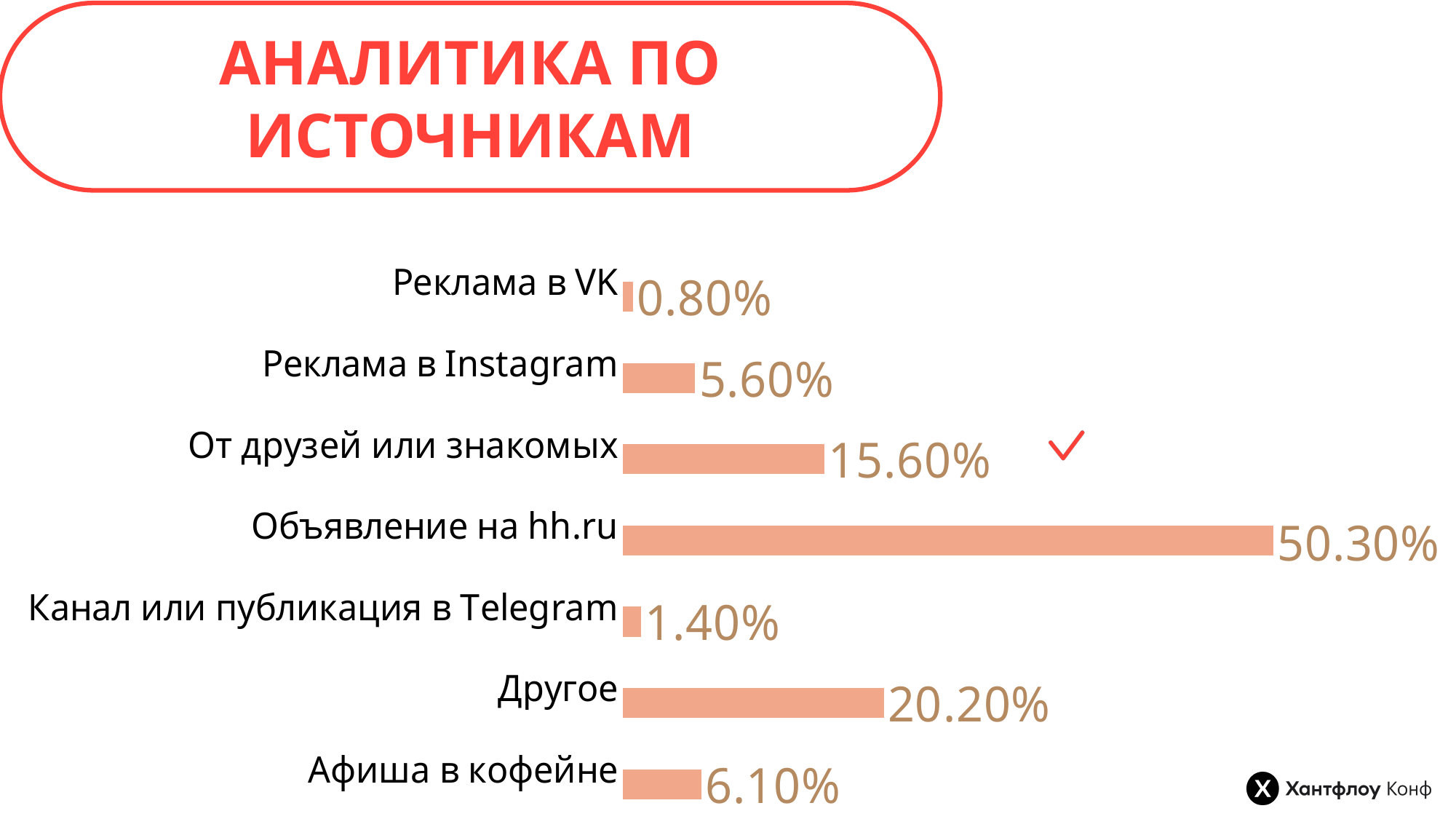
What is the value for Реклама в VK? 0.80% What is the value for Афиша в кофейне? 6.10% Which category has the highest value? Объявление на hh.ru What is the title of the slide? АНАЛИТИКА ПО ИСТОЧНИКАМ How many categories are shown in the chart? 7 What is the difference between the values for Другое and От друзей или знакомых? 4.60% Which category has the lowest value? Реклама в VK What is the difference between the values for Объявление на hh.ru and Другое? 30.10% Which is larger, the value for Реклама в Instagram or the value for Афиша в кофейне? Афиша в кофейне What is the value for Объявление на hh.ru? 50.30% What is the value for Канал или публикация в Telegram? 1.40% What kind of chart is shown on the slide? Bar chart